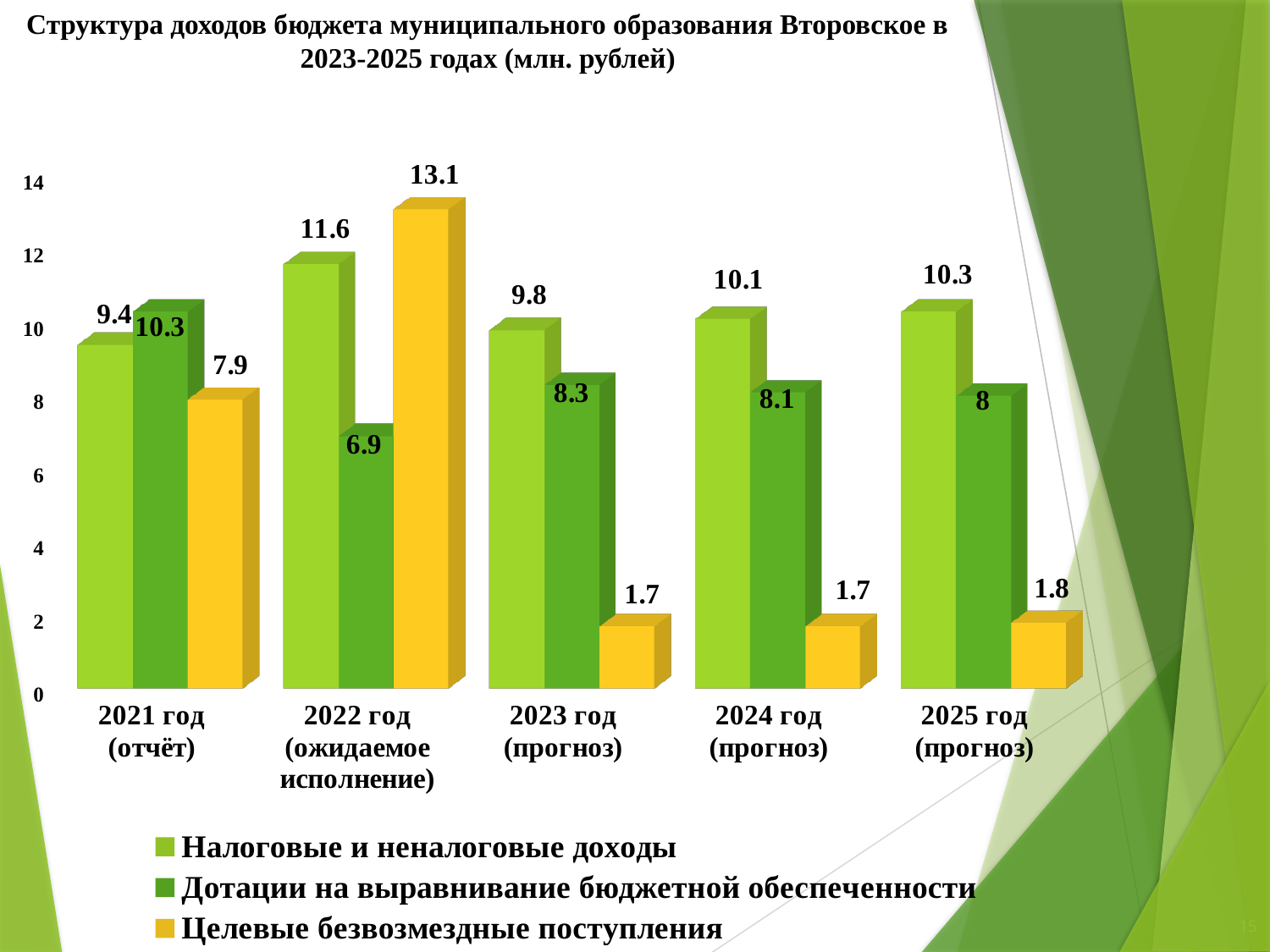
How many year categories are shown on the x axis? 5 In which year is Целевые безвозмездные поступления highest? 2022 год (ожидаемое исполнение) What kind of chart is shown on the slide? Bar chart What is the value of Целевые безвозмездные поступления for 2025 год (прогноз)? 1.8 How many series does the legend list? 3 What is the total of the three series for 2023 год (прогноз)? 19.8 What is the difference between Налоговые и неналоговые доходы and Дотации на выравнивание бюджетной обеспеченности in 2024 год (прогноз)? 2 What is the value of Налоговые и неналоговые доходы for 2022 год (ожидаемое исполнение)? 11.6 In which year is Дотации на выравнивание бюджетной обеспеченности lowest? 2022 год (ожидаемое исполнение) Which is larger in 2021 год (отчёт): Налоговые и неналоговые доходы or Дотации на выравнивание бюджетной обеспеченности? Дотации на выравнивание бюджетной обеспеченности Does Налоговые и неналоговые доходы rise or fall from 2023 год (прогноз) to 2025 год (прогноз)? Rise What is the value of Дотации на выравнивание бюджетной обеспеченности for 2023 год (прогноз)? 8.3